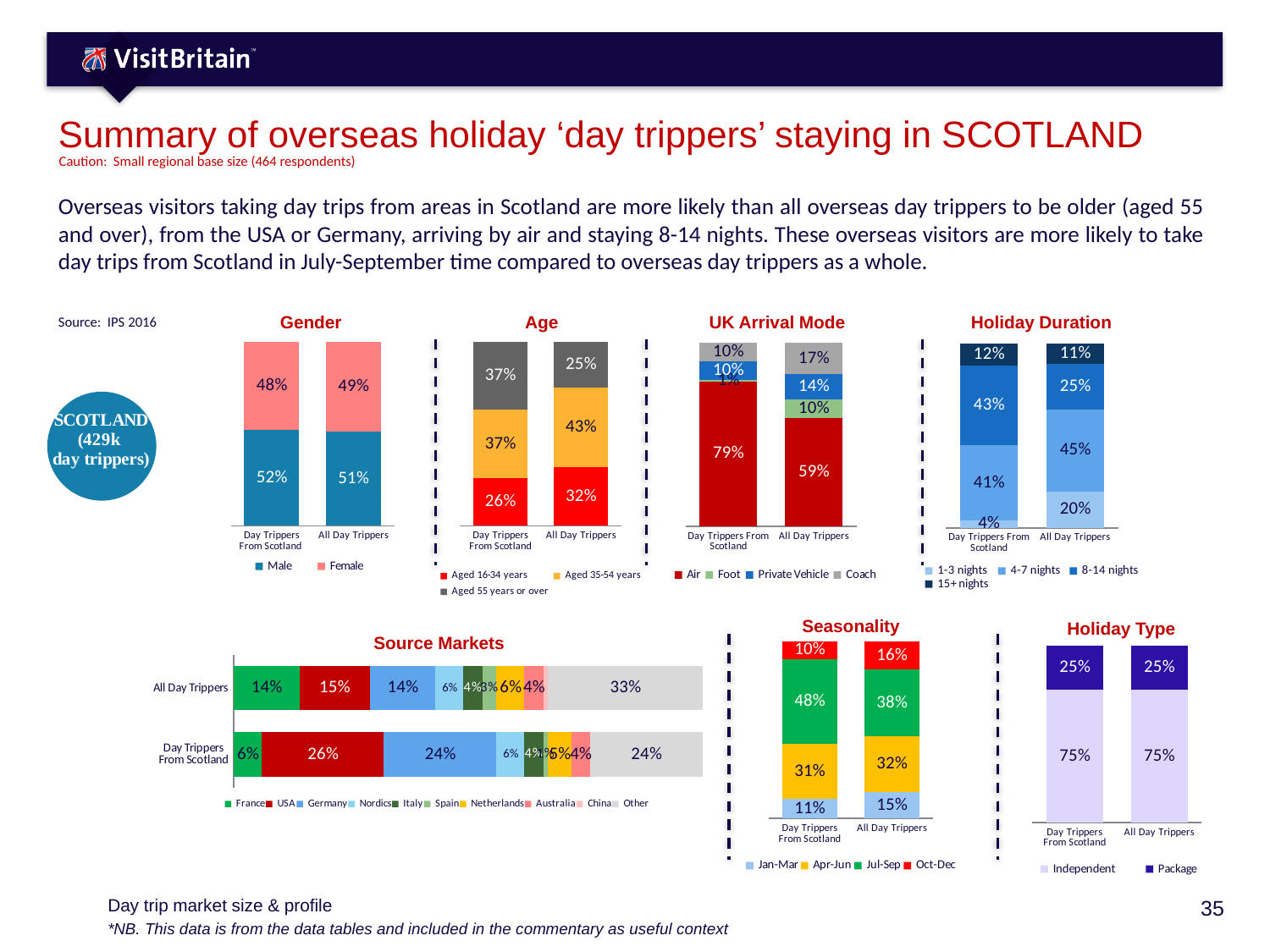
In the UK Arrival Mode chart, what percentage of Day Trippers From Scotland arrive by Air? 79% In the Holiday Type chart, what percentage of All Day Trippers are on a Package holiday? 25% In the Source Markets chart, what is the share of Other for All Day Trippers? 33% In the Source Markets chart, what percentage of Day Trippers From Scotland come from the USA? 26% In the Age chart, what is the difference between the Aged 55 years or over share for Day Trippers From Scotland and for All Day Trippers? 12 percentage points In the Age chart, what percentage of All Day Trippers are Aged 35-54 years? 43% In the Seasonality chart, how many series does the legend list? 4 In the Gender chart, what percentage of Day Trippers From Scotland are Male? 52% In the UK Arrival Mode chart, which arrival mode has the largest share for All Day Trippers? Air In the Holiday Duration chart, which is larger for All Day Trippers: the 1-3 nights share or the 4-7 nights share? 4-7 nights In the Holiday Duration chart, what percentage of Day Trippers From Scotland stay 8-14 nights? 43% In the Seasonality chart, what percentage of Day Trippers From Scotland take trips in Jul-Sep? 48%